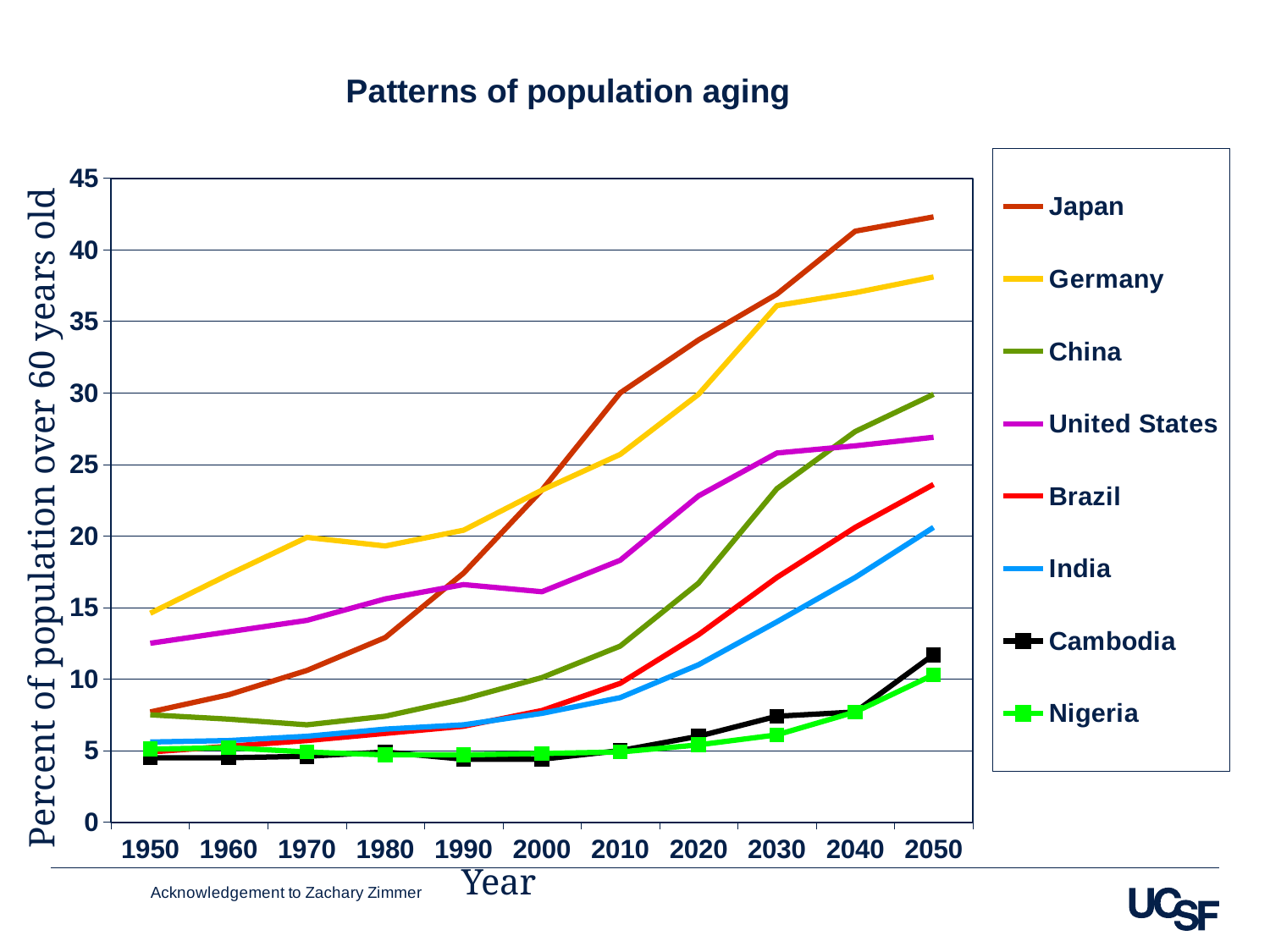
Is the value for India in 2000 greater or less than 10? less How many years are shown along the x axis? 11 Is the value for China in 2050 greater or less than 25? greater In 2010, which is larger: the value for Japan or the value for Germany? Japan What is the title of the chart? Patterns of population aging How many series does the legend list? 8 Which country has the highest percent of population over 60 years old in 2050? Japan Which country has the highest percent of population over 60 years old in 1950? Germany Is the value for Germany in 2050 greater or less than 35? greater What kind of chart is shown on the slide? line chart Does the value for Japan rise or fall from 1950 to 2050? rise